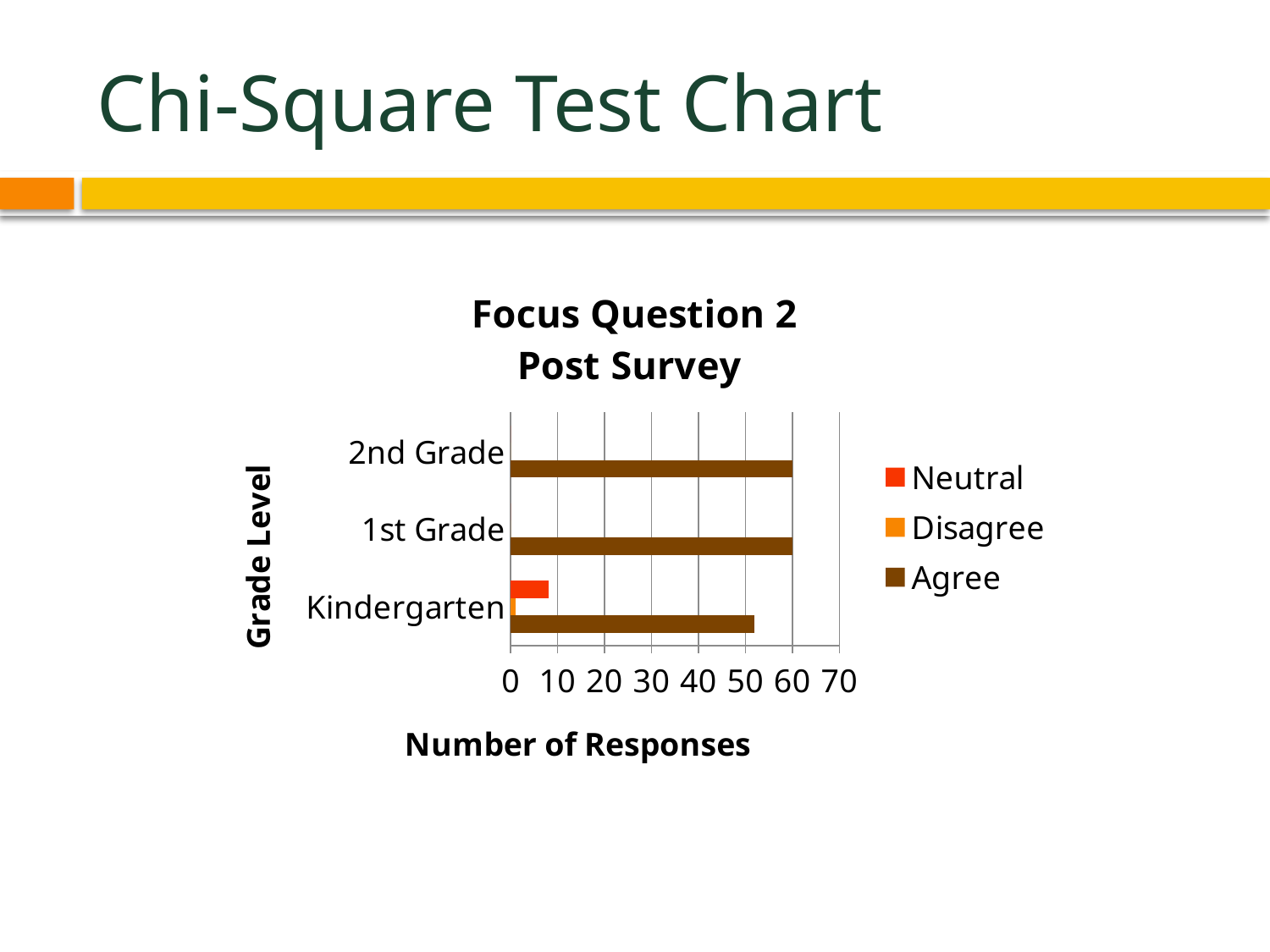
What is the label on the horizontal axis of the chart? Number of Responses Which is larger: the Agree responses for Kindergarten or the Agree responses for 2nd Grade? 2nd Grade Is the number of Neutral responses for Kindergarten greater or less than 10? less For Kindergarten, which response category has the most responses? Agree What is the number of Agree responses for 2nd Grade? 60 How many series does the legend list? 3 How many grade levels are shown on the y axis of the chart? 3 What is the title of the chart? Focus Question 2 Post Survey What is the number of Agree responses for 1st Grade? 60 Which grade level has the lowest number of Agree responses? Kindergarten Is the number of Agree responses for Kindergarten greater or less than 40? greater What kind of chart is shown on the slide? bar chart